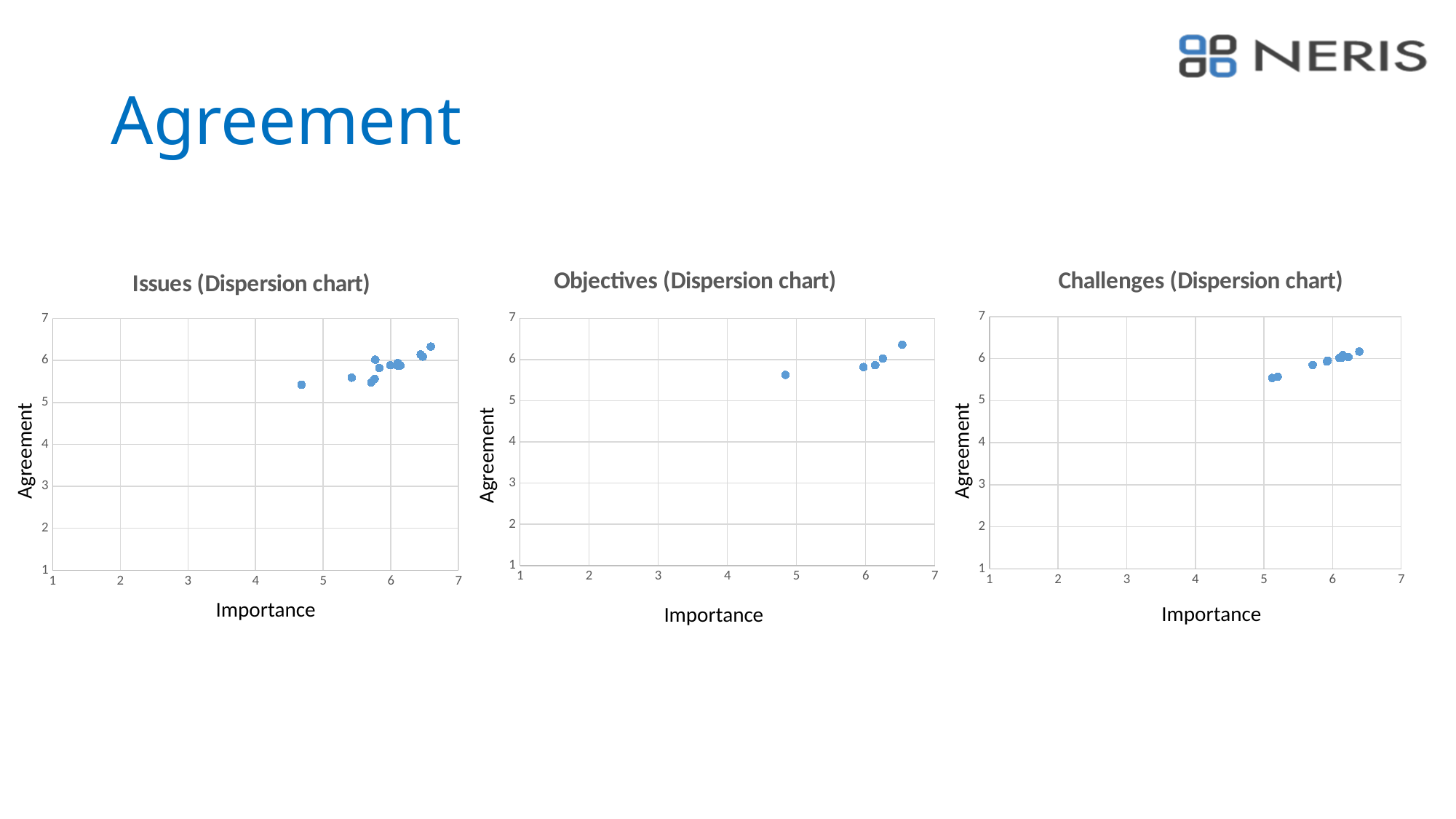
On the Challenges (Dispersion chart), do the Agreement values generally rise or fall as Importance increases? rise On the Objectives (Dispersion chart), is the Agreement value of the leftmost point greater or less than 5? greater On the Issues (Dispersion chart), is the Importance value of the leftmost point greater or less than 5? less What is the maximum value shown on the y axis of the Challenges (Dispersion chart)? 7 On the Objectives (Dispersion chart), is the Importance value of the rightmost point greater or less than 6? greater On the Objectives (Dispersion chart), do the Agreement values generally rise or fall as Importance increases? rise How many data points are plotted on the Objectives (Dispersion chart)? 5 What is the label of the x axis on the Challenges (Dispersion chart)? Importance What is the title of the middle chart on the slide? Objectives (Dispersion chart) What kind of chart is the Issues (Dispersion chart)? Scatter chart